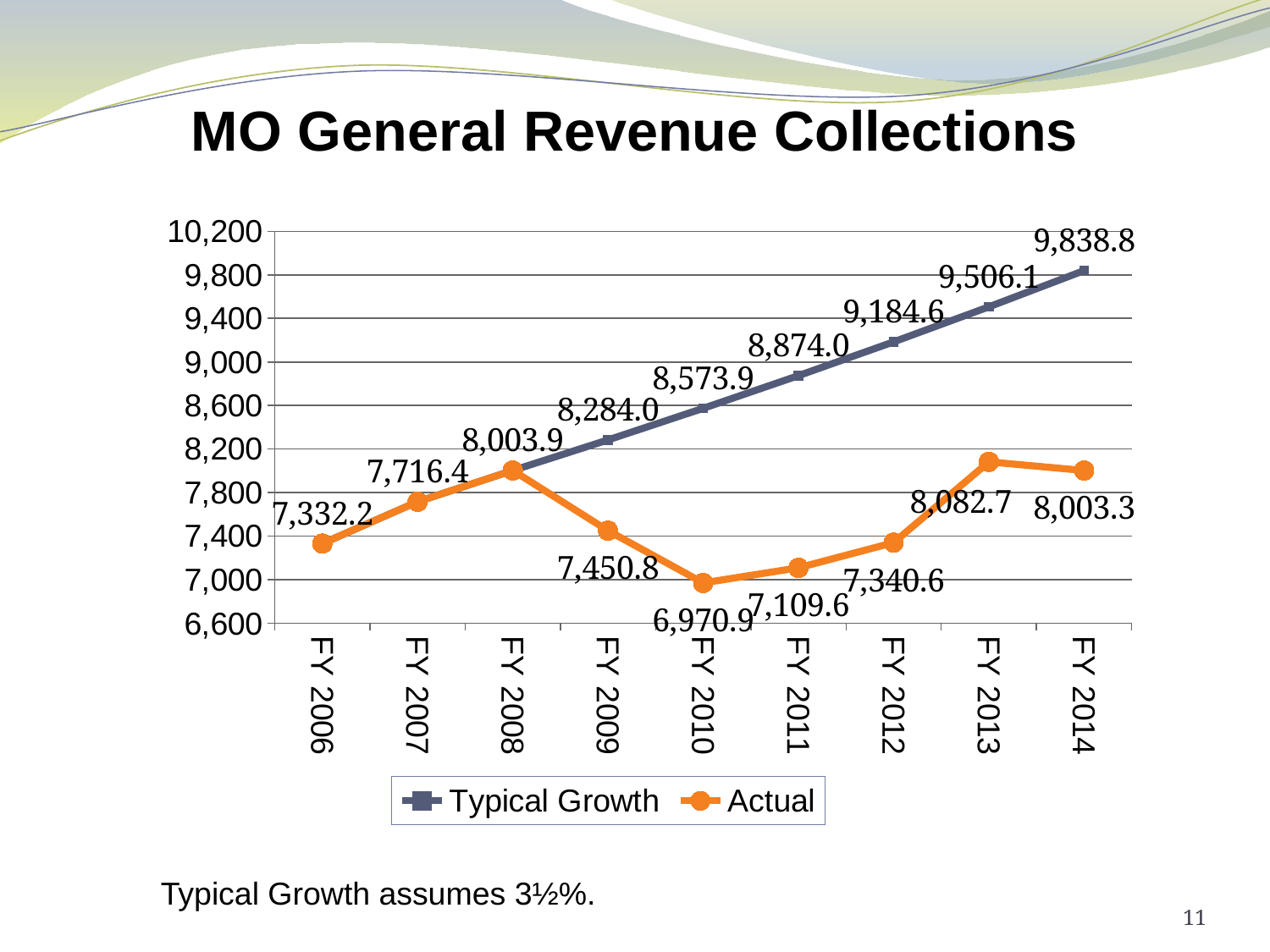
What are the two series named in the legend? Typical Growth and Actual What is the Actual value for FY 2010? 6,970.9 Which is larger, the Actual value for FY 2013 or for FY 2014? FY 2013 In which fiscal year is the Actual value lowest? FY 2010 How many series does the legend list? 2 What kind of chart is shown on the slide? Line chart Does the Typical Growth line rise or fall from FY 2008 to FY 2014? Rise In which fiscal year is the Actual value highest? FY 2013 What is the difference between the Typical Growth and Actual values in FY 2014? 1,835.5 What is the Typical Growth value for FY 2011? 8,874.0 What is the Typical Growth value for FY 2014? 9,838.8 How many fiscal years are shown on the x axis? 9